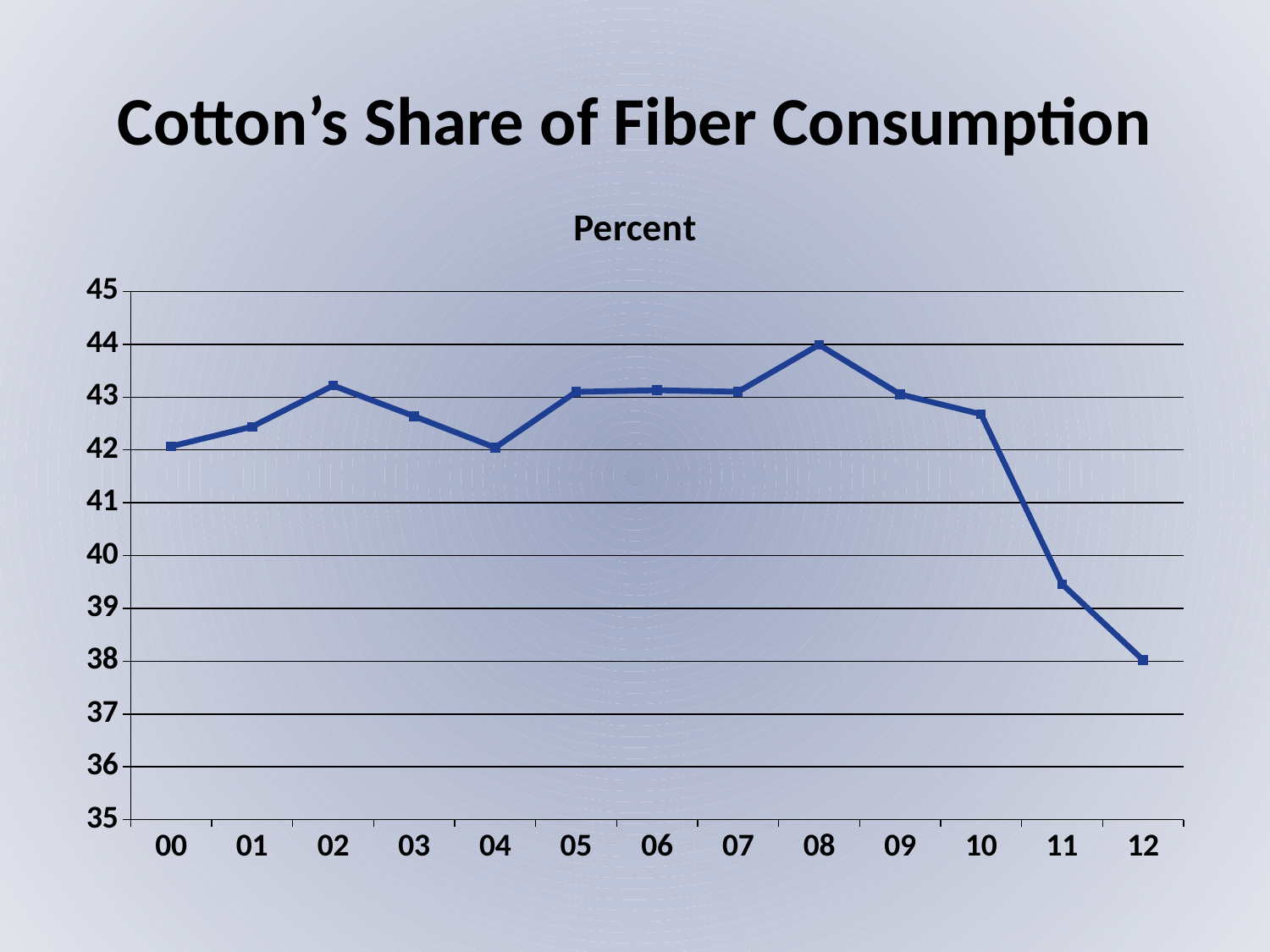
Which year has the lowest cotton share of fiber consumption? 12 Is the value for 11 greater or less than 40? less How many years are plotted along the x axis? 13 Is the value for 12 greater or less than 39? less What kind of chart is shown on the slide? line chart What is the title of the chart on the slide? Percent Which year has the larger value, 10 or 11? 10 Do the values rise or fall from 10 to 12? fall Is the value for 08 greater or less than 43? greater Which year has the larger value, 02 or 04? 02 Which year has the highest cotton share of fiber consumption? 08